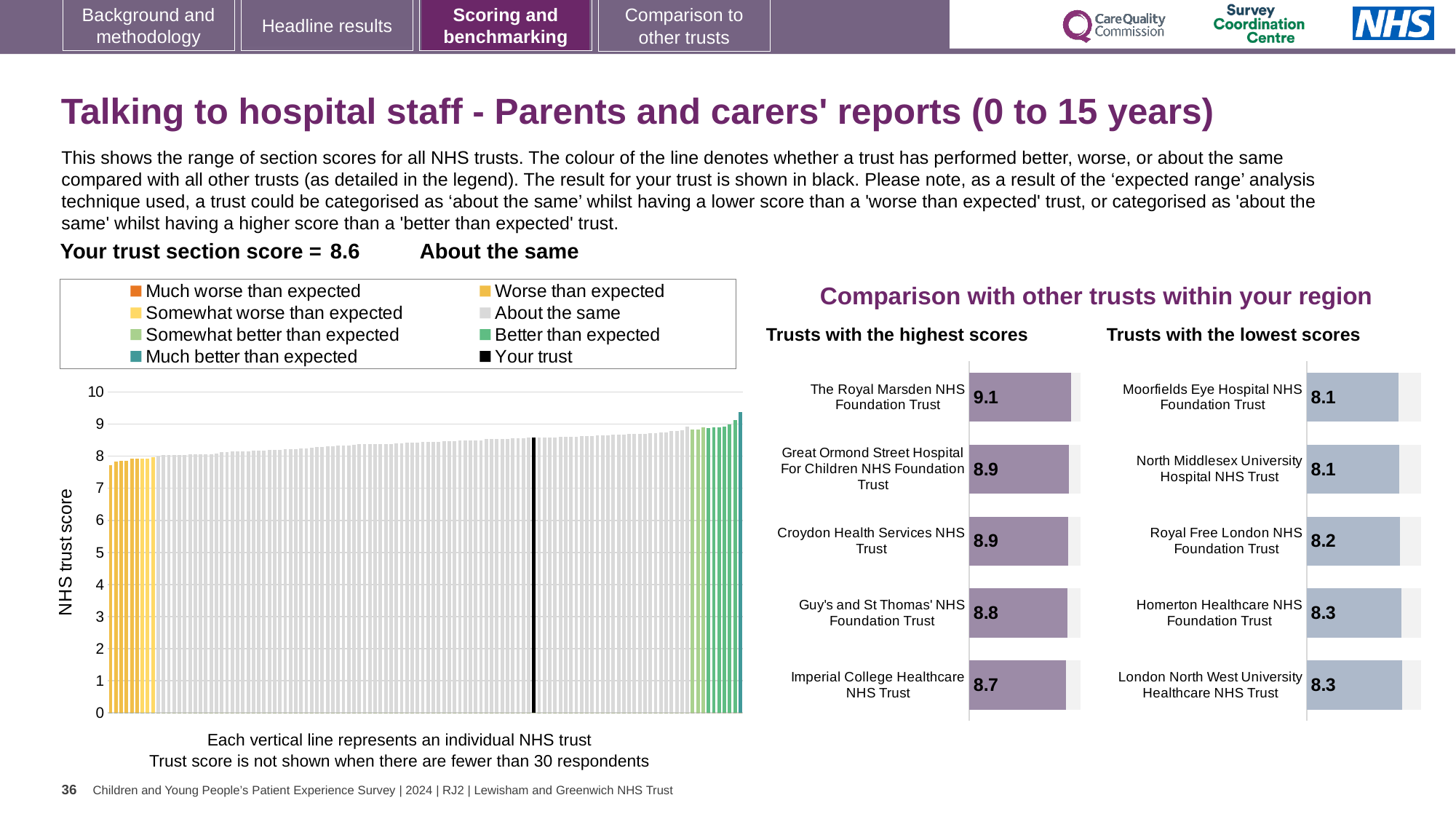
How many entries does the legend of the main 'NHS trust score' chart list? 8 In the 'Trusts with the highest scores' chart, what is the score for The Royal Marsden NHS Foundation Trust? 9.1 In the 'Trusts with the lowest scores' chart, what is the score for Royal Free London NHS Foundation Trust? 8.2 In the main 'NHS trust score' chart on the left, is the value for the black 'Your trust' bar greater or less than 8? greater In the 'Trusts with the highest scores' chart, what is the score for Imperial College Healthcare NHS Trust? 8.7 In the 'Trusts with the lowest scores' chart, which has the larger score: Royal Free London NHS Foundation Trust or Moorfields Eye Hospital NHS Foundation Trust? Royal Free London NHS Foundation Trust In the main 'NHS trust score' chart on the left, do the bar values rise or fall from left to right along the x axis? rise What kind of chart is the main 'NHS trust score' chart on the left? bar chart In the 'Trusts with the highest scores' chart, what is the difference between the scores of The Royal Marsden NHS Foundation Trust and Imperial College Healthcare NHS Trust? 0.4 In the 'Trusts with the lowest scores' chart, what is the difference between the scores of Homerton Healthcare NHS Foundation Trust and Moorfields Eye Hospital NHS Foundation Trust? 0.2 In the 'Trusts with the highest scores' chart, which trust has the highest score? The Royal Marsden NHS Foundation Trust How many trusts are listed in the 'Trusts with the lowest scores' chart? 5